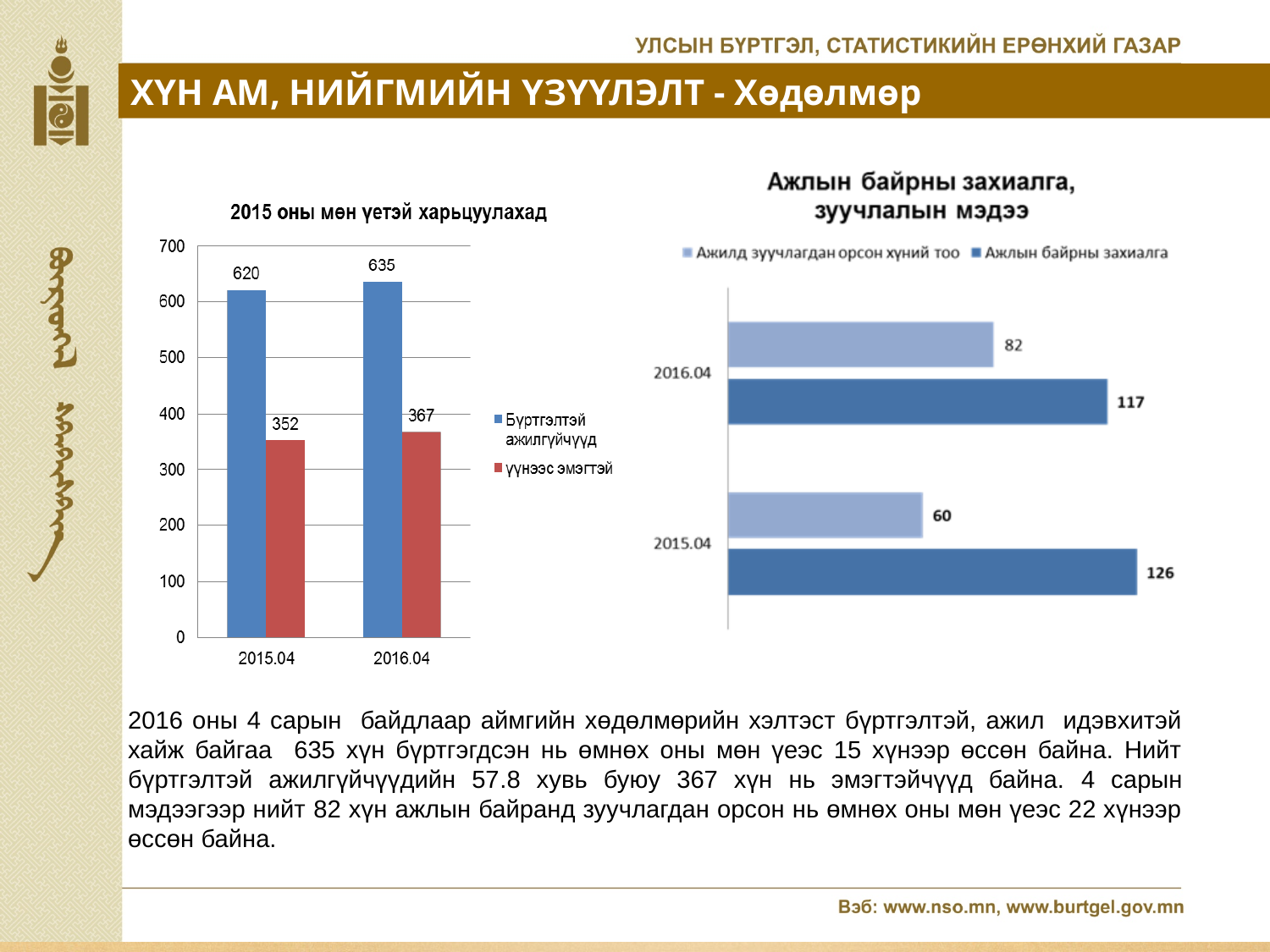
In the right chart 'Ажлын байрны захиалга, зуучлалын мэдээ', what is the value for 'Ажлын байрны захиалга' in 2015.04? 126 In the left chart '2015 оны мөн үетэй харьцуулахад', what is the difference between 'Бүртгэлтэй ажилгүйчүүд' and 'үүнээс эмэгтэй' in 2016.04? 268 In the right chart 'Ажлын байрны захиалга, зуучлалын мэдээ', how many categories are shown on the vertical axis? 2 In the right chart 'Ажлын байрны захиалга, зуучлалын мэдээ', what is the value for 'Ажилд зуучлагдан орсон хүний тоо' in 2016.04? 82 In the left chart '2015 оны мөн үетэй харьцуулахад', how many series does the legend list? 2 What kind of chart is the left chart '2015 оны мөн үетэй харьцуулахад'? Bar chart In the left chart '2015 оны мөн үетэй харьцуулахад', what is the value for 'үүнээс эмэгтэй' in 2015.04? 352 In the right chart 'Ажлын байрны захиалга, зуучлалын мэдээ', which series has the lowest value shown? Ажилд зуучлагдан орсон хүний тоо (2015.04) In the right chart 'Ажлын байрны захиалга, зуучлалын мэдээ', what is the difference between 'Ажилд зуучлагдан орсон хүний тоо' in 2016.04 and 2015.04? 22 In the left chart '2015 оны мөн үетэй харьцуулахад', by how much did 'Бүртгэлтэй ажилгүйчүүд' change from 2015.04 to 2016.04? 15 In the right chart 'Ажлын байрны захиалга, зуучлалын мэдээ', which year has the higher value for 'Ажлын байрны захиалга', 2015.04 or 2016.04? 2015.04 In the left chart '2015 оны мөн үетэй харьцуулахад', what is the value for 'Бүртгэлтэй ажилгүйчүүд' in 2016.04? 635